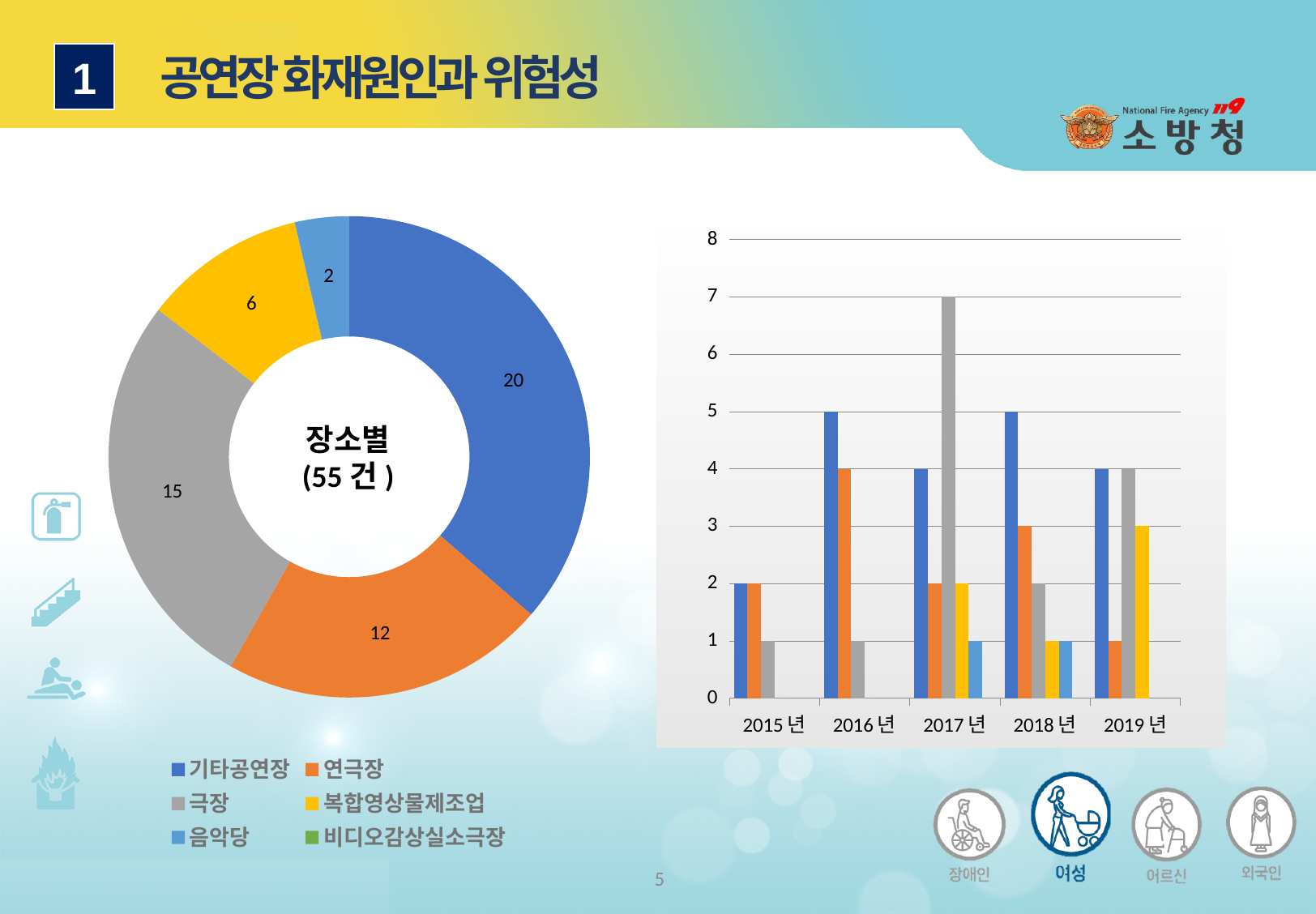
On the bar chart on the right, in which year does the tallest bar appear? 2017 년 On the doughnut chart on the left, what value is shown for 기타공연장? 20 How many years are shown on the x axis of the bar chart on the right? 5 On the doughnut chart on the left, what value is shown for 극장? 15 What kind of chart is on the right side of the slide? bar chart On the doughnut chart on the left, which category has the largest value? 기타공연장 On the doughnut chart on the left, what is the difference between the values for 기타공연장 and 연극장? 8 How many entries does the legend of the doughnut chart on the left list? 6 On the doughnut chart on the left, what total number of cases is shown in the centre? 55 건 On the doughnut chart on the left, what value is shown for 복합영상물제조업? 6 On the doughnut chart on the left, which is larger: 극장 or 연극장? 극장 On the doughnut chart on the left, which labelled slice has the smallest value? 음악당